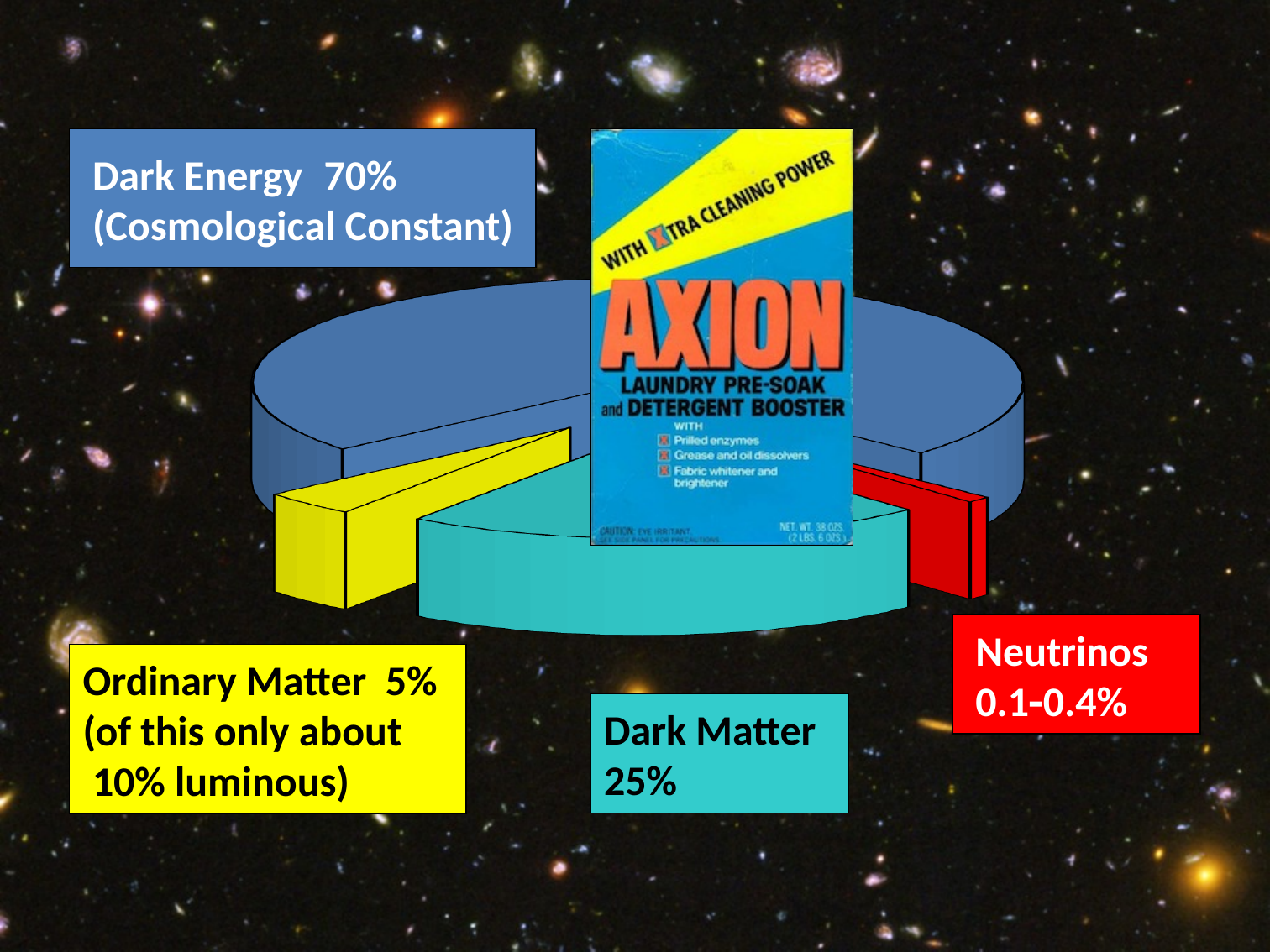
What share of the pie is labelled for Dark Energy? 70% What share of the pie is labelled for Ordinary Matter? 5% What kind of chart is shown on the slide? pie chart What colour is the Neutrinos slice? red What colour is the Dark Matter slice? cyan Which is larger, the Dark Matter slice or the Ordinary Matter slice? Dark Matter How many slices does the pie chart have? 4 What is the difference between the Dark Energy share and the Dark Matter share? 45% What share of the pie is labelled for Dark Matter? 25% Which slice of the pie is the smallest? Neutrinos What share is labelled for Neutrinos? 0.1-0.4% Which slice of the pie is the largest? Dark Energy